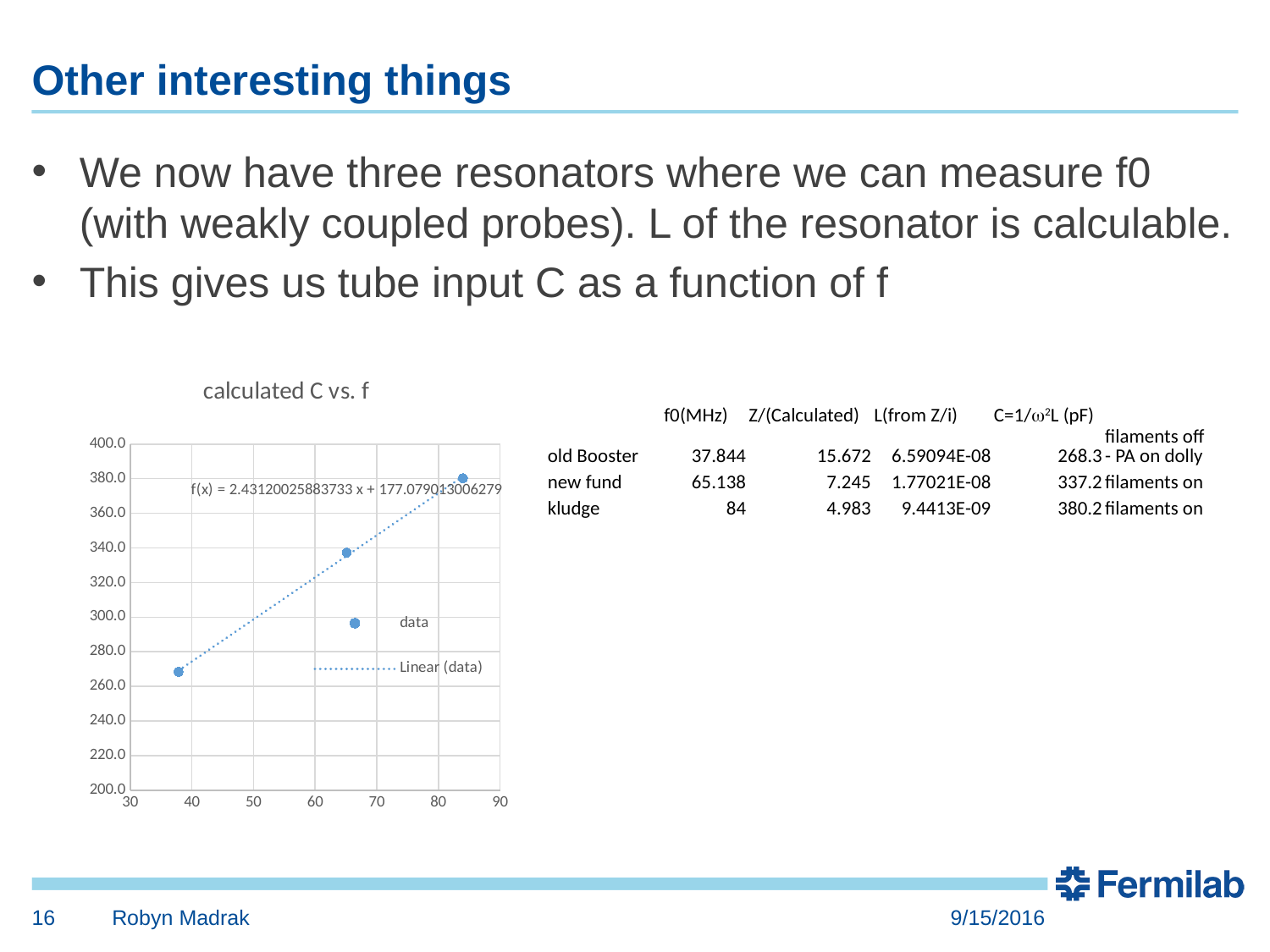
What is the title of the chart? calculated C vs. f Which data point has the highest plotted value: the one near x = 38 or the one near x = 84? the one near x = 84 Is the value of the data point near x = 38 greater or less than 280? less What is the maximum value shown on the y axis of the chart? 400.0 What kind of chart is shown on the slide? scatter chart How many entries does the chart legend list? 2 Is the value of the data point near x = 84 greater or less than 360? greater Is the value of the highest data point near x = 65 greater or less than 320? greater What is the trendline equation printed on the chart? f(x) = 2.43120025883733 x + 177.079013006279 Do the plotted values generally rise or fall as f increases along the x axis? rise How many data points are plotted in the chart? 3